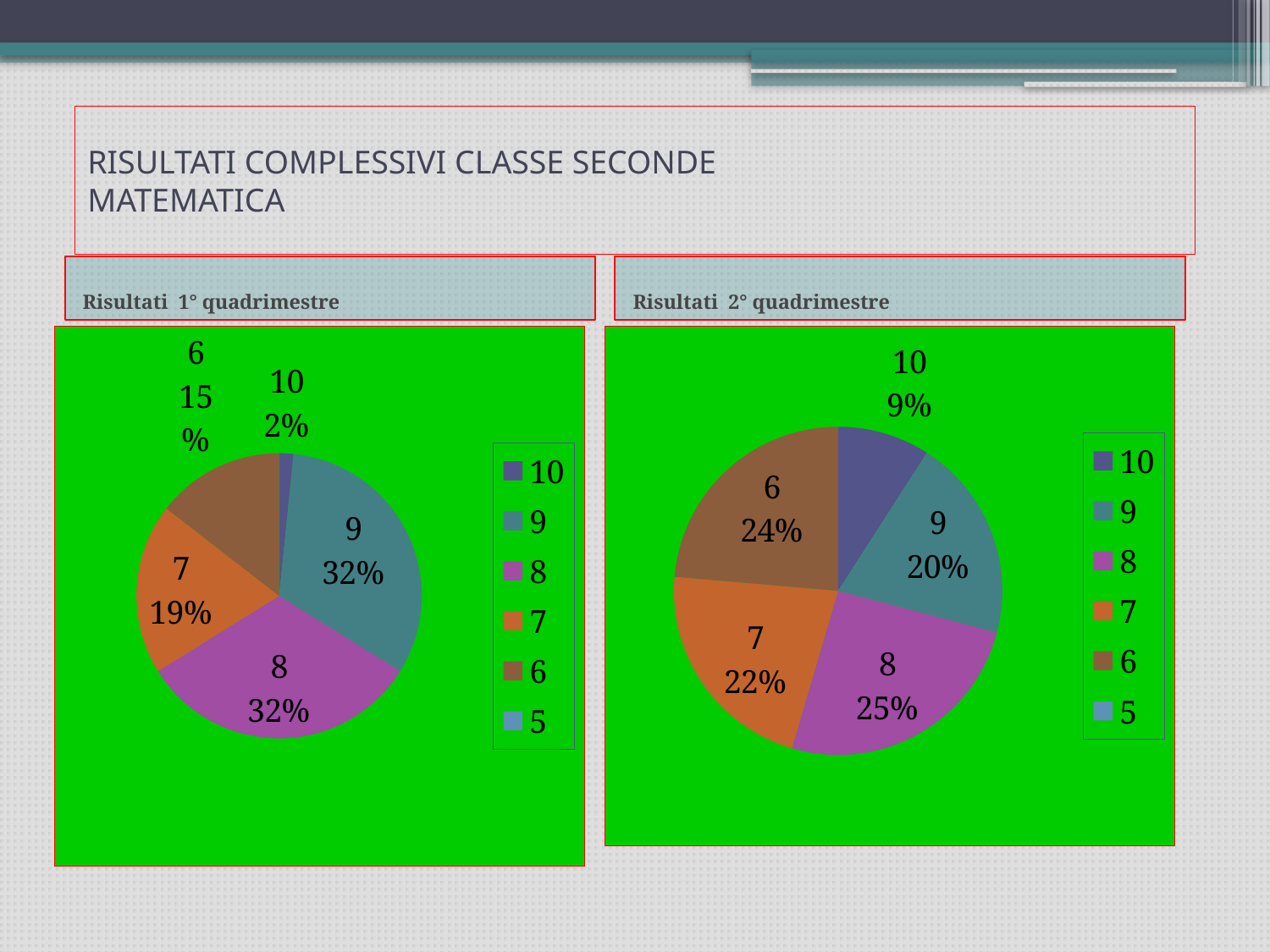
In the 'Risultati 1° quadrimestre' chart, what share does grade 9 have? 32% How many entries does the legend of the 'Risultati 2° quadrimestre' chart list? 6 In the 'Risultati 2° quadrimestre' chart, what share does grade 6 have? 24% In the 'Risultati 2° quadrimestre' chart, which grade has the largest slice? 8 In the 'Risultati 2° quadrimestre' chart, what share does grade 10 have? 9% In the 'Risultati 2° quadrimestre' chart, which is larger, the share for grade 7 or the share for grade 9? 7 In the 'Risultati 1° quadrimestre' chart, what is the difference in percentage points between grade 7 and grade 6? 4 How many slices with labels are shown in the 'Risultati 1° quadrimestre' pie? 5 In the 'Risultati 1° quadrimestre' chart, what share does grade 7 have? 19% In the 'Risultati 2° quadrimestre' chart, which grade has the smallest slice? 10 In the 'Risultati 1° quadrimestre' chart, which grade has the smallest slice? 10 What type of chart is used for 'Risultati 1° quadrimestre'? Pie chart